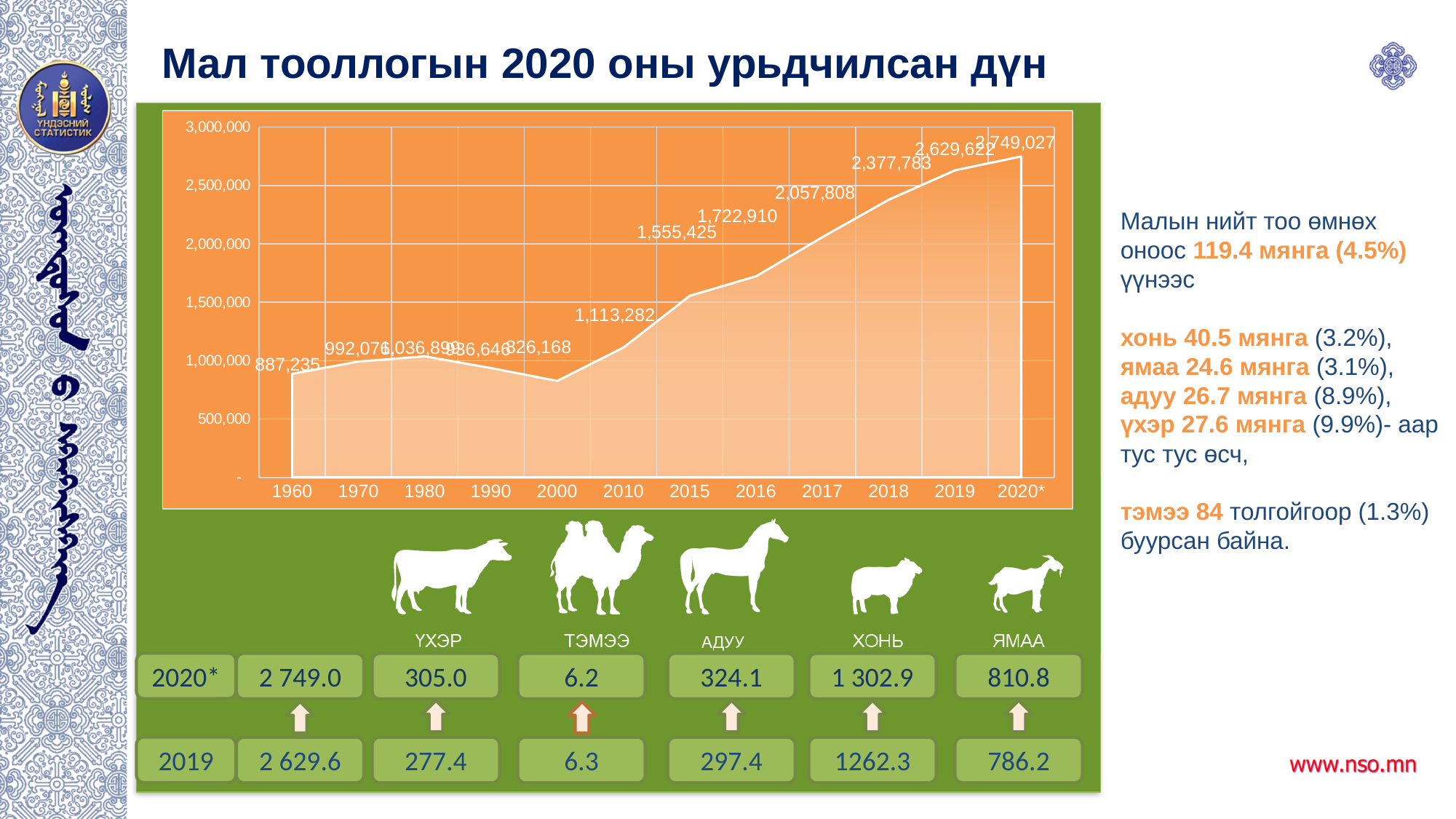
Which year has the lowest value on the chart? 2000 What type of chart is shown on the slide? area chart What is the value plotted for 1960? 887,235 How many years are plotted on the x axis of the chart? 12 Which year has the highest value on the chart? 2020* Which is larger, the value for 1970 or the value for 1990? 1970 Do the values rise or fall from 2000 to 2020* on the chart? rise What is the value plotted for 2000? 826,168 What is the difference between the values for 2020* and 2019? 119,405 What is the value plotted for 2017? 2,057,808 What is the value plotted for 2010? 1,113,282 What is the value plotted for 2020*? 2,749,027